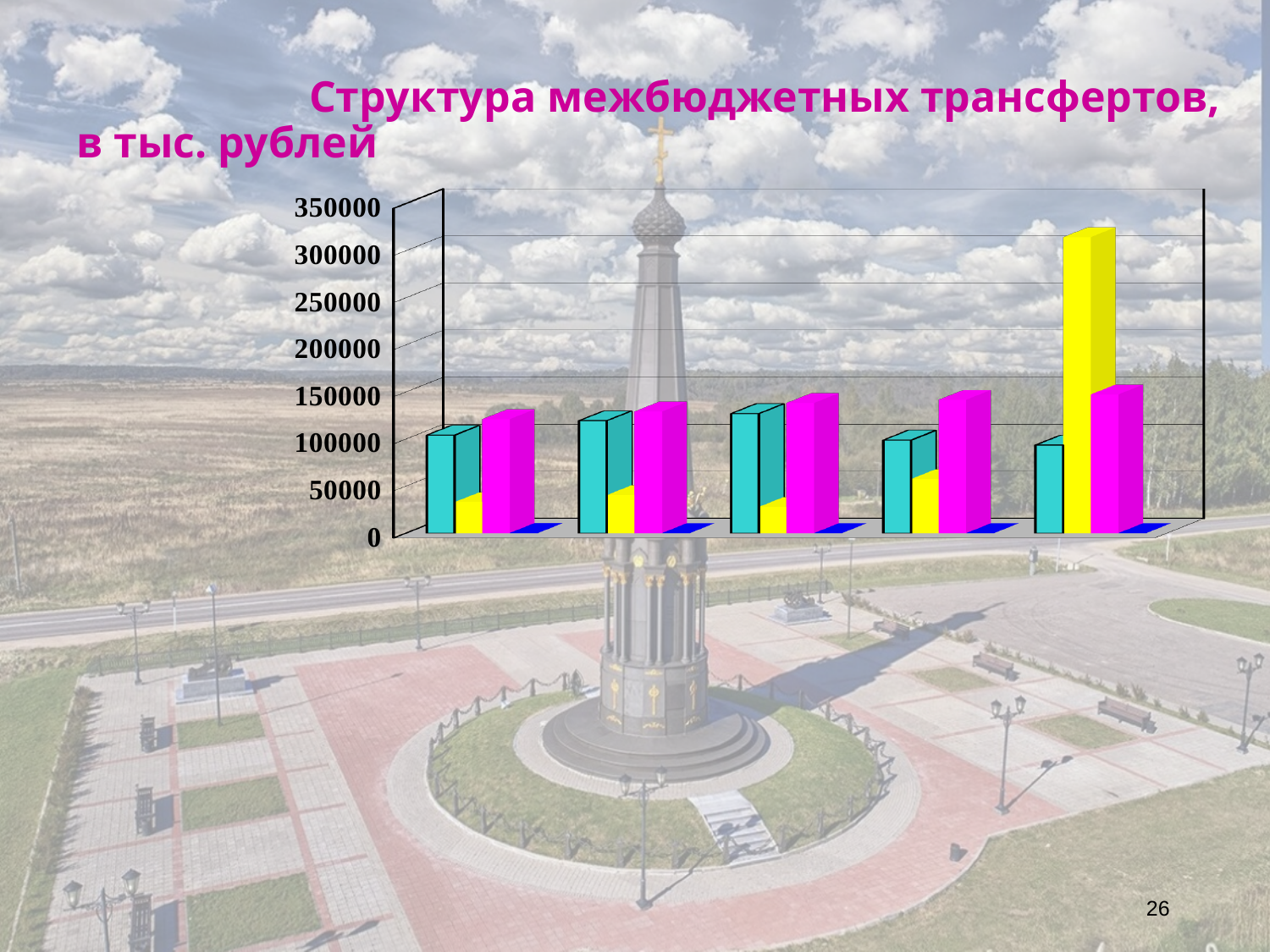
What kind of chart is shown on the slide? bar chart In the leftmost group, which is larger: the cyan bar or the yellow bar? the cyan bar How many groups of bars are plotted along the x axis? 5 Is the yellow bar in the rightmost group greater or less than 300000? greater In the rightmost group, which is larger: the yellow bar or the magenta bar? the yellow bar How many different bar colours (series) appear in each group? 4 Which group of bars contains the tallest bar on the chart? the rightmost (fifth) group What is the title of the chart? Структура межбюджетных трансфертов, в тыс. рублей What is the highest value shown on the vertical axis? 350000 Is the cyan bar in the leftmost group greater or less than 150000? less Is the magenta bar in the rightmost group greater or less than 200000? less